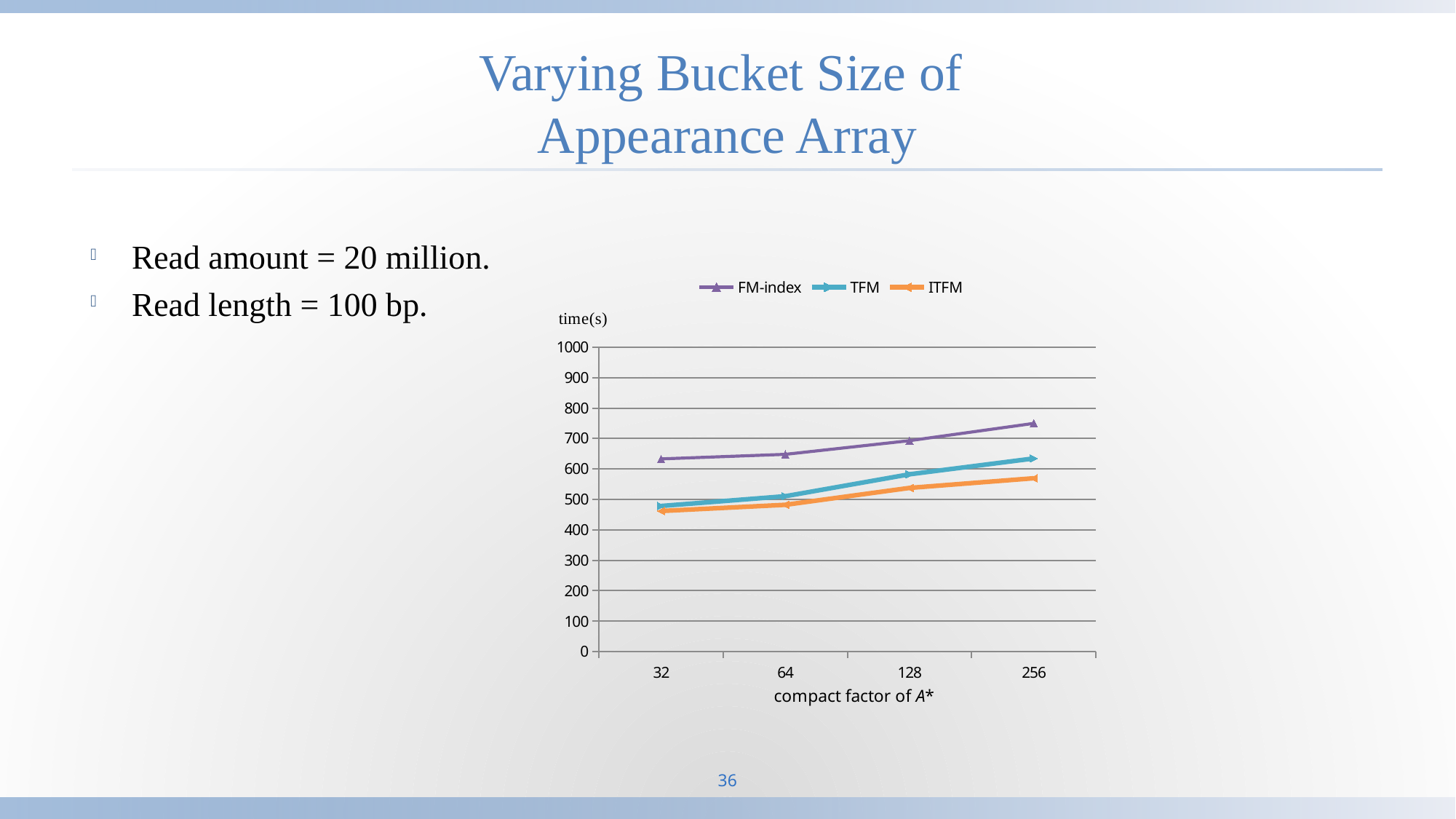
Is the ITFM value at compact factor 32 greater or less than 500? less At compact factor 128, which is larger: the FM-index value or the TFM value? FM-index Is the FM-index value at compact factor 256 greater or less than 700? greater What is the label of the x axis? compact factor of A* Is the TFM value at compact factor 128 greater or less than 500? greater Do the TFM values rise or fall as the compact factor increases from 32 to 256? rise How many compact factor values are plotted along the x axis? 4 What kind of chart is shown on the slide? line chart Which series has the lowest time at compact factor 32? ITFM Which series has the highest time at compact factor 256? FM-index How many series does the legend list? 3